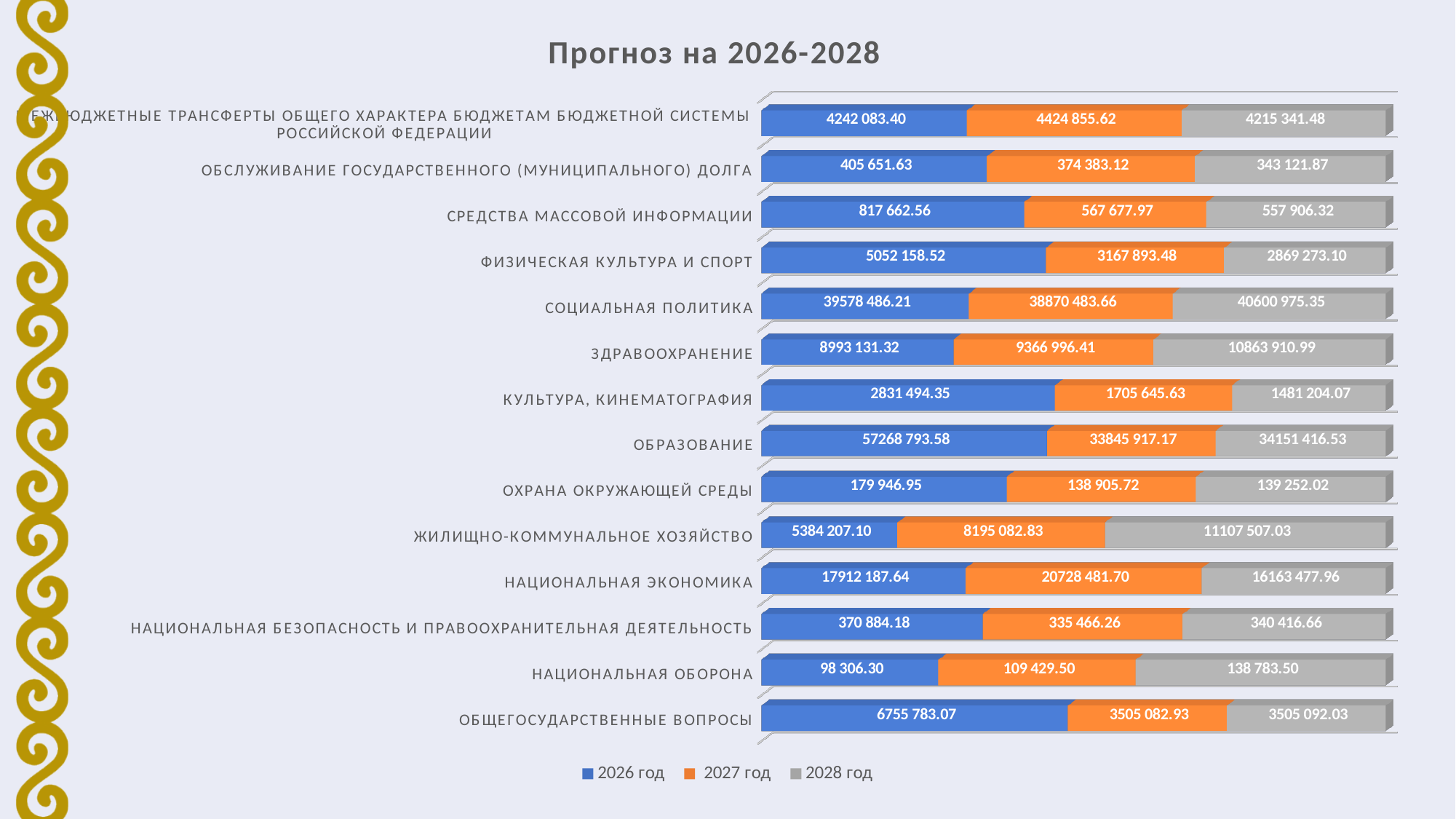
What kind of chart is shown on the slide? Stacked bar chart What is the 2028 год value for ЖИЛИЩНО-КОММУНАЛЬНОЕ ХОЗЯЙСТВО? 11107 507.03 What is the difference between the 2028 год and 2026 год values for НАЦИОНАЛЬНАЯ ОБОРОНА? 40 477.20 Which category has the lowest 2026 год value? НАЦИОНАЛЬНАЯ ОБОРОНА Which is larger for СОЦИАЛЬНАЯ ПОЛИТИКА: the 2026 год value or the 2028 год value? 2028 год What is the 2027 год value for НАЦИОНАЛЬНАЯ ЭКОНОМИКА? 20728 481.70 What is the difference between the 2026 год and 2028 год values for ОБСЛУЖИВАНИЕ ГОСУДАРСТВЕННОГО (МУНИЦИПАЛЬНОГО) ДОЛГА? 62 529.76 Which category has the highest 2026 год value? ОБРАЗОВАНИЕ What is the title of the chart? Прогноз на 2026-2028 What is the 2026 год value for ЗДРАВООХРАНЕНИЕ? 8993 131.32 How many series does the legend list? 3 How many categories are shown in the chart? 14